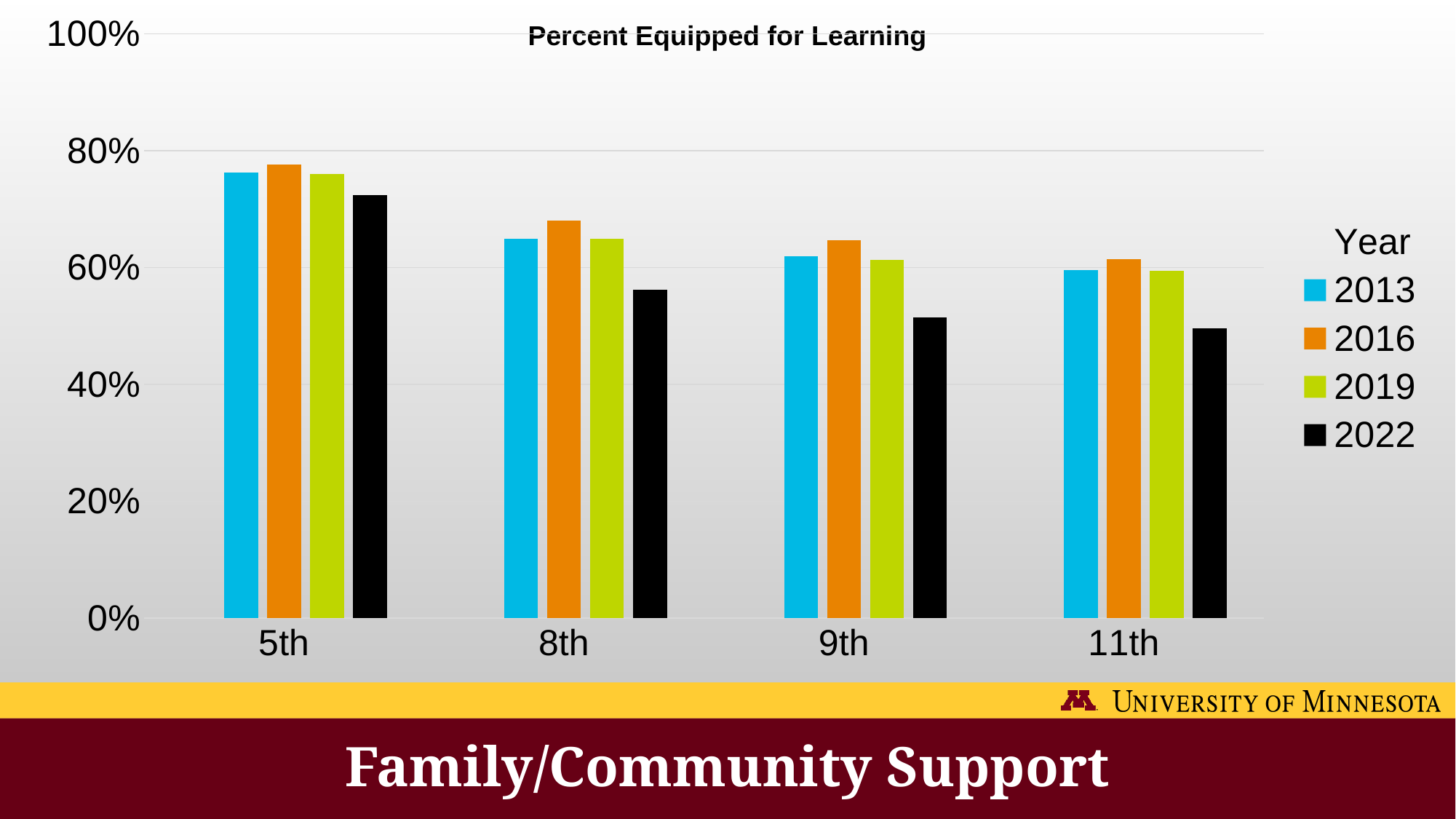
How many grade categories are shown on the x axis? 4 Which is larger, the 2022 value for 5th grade or the 2022 value for 8th grade? 5th grade What is the title of the chart? Percent Equipped for Learning Which grade has the highest value for 2022? 5th What kind of chart is shown on the slide? bar chart Is the value for 2022 in 11th grade greater or less than 60%? less Which year has the lowest value for 9th grade? 2022 How many years does the legend list? 4 Is the value for 2022 in 9th grade greater or less than 60%? less What colour are the bars for 2022? black Do the 2022 values rise or fall from 5th grade to 11th grade? fall Is the value for 2016 in 5th grade greater or less than 60%? greater